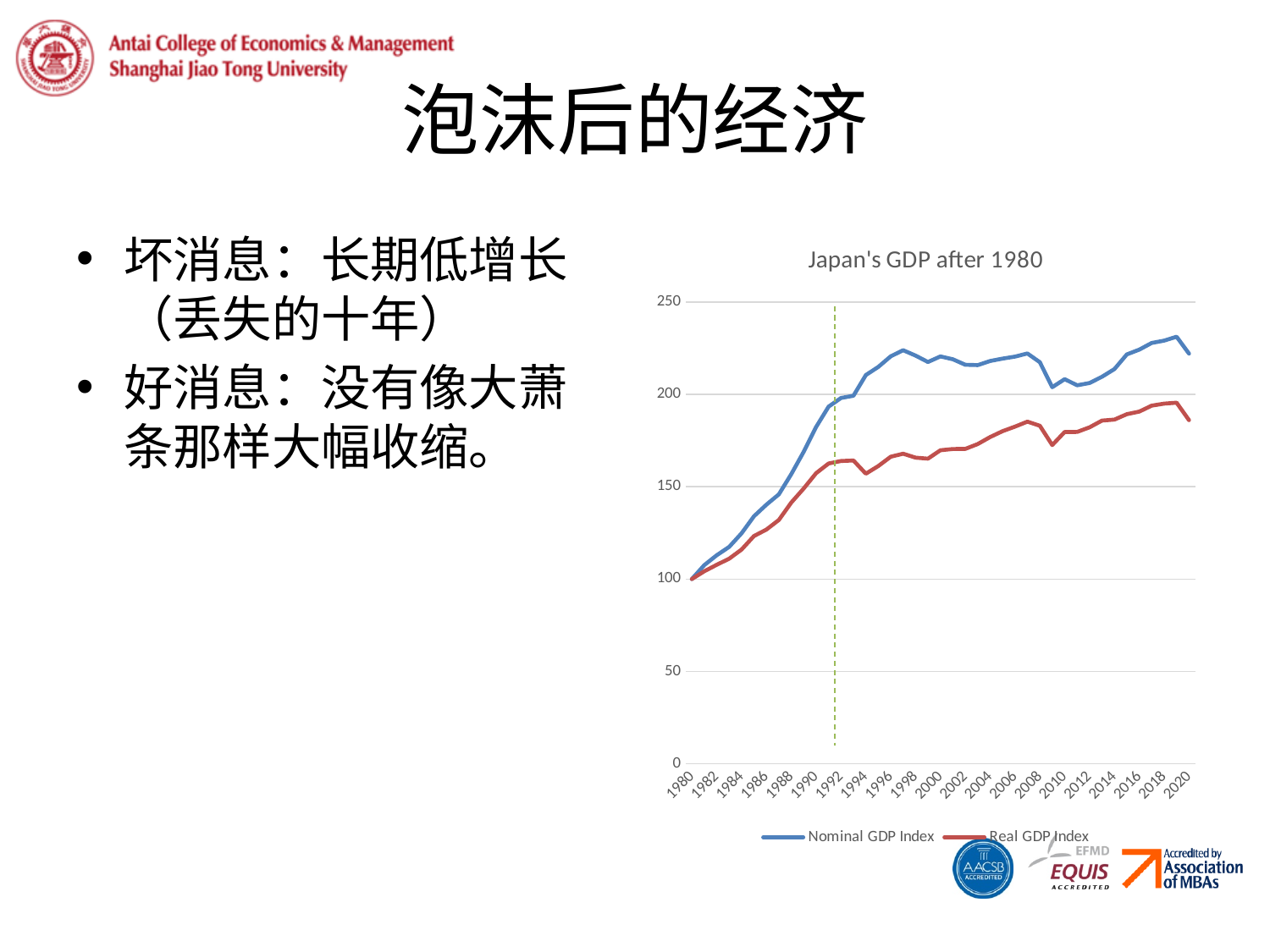
Is the value of the Nominal GDP Index in 2020 greater or less than 200? greater What is the title of the chart? Japan's GDP after 1980 In 2010, which series has the higher value, the Nominal GDP Index or the Real GDP Index? Nominal GDP Index Does the Nominal GDP Index rise or fall between 1980 and 1990? rise Which two series are listed in the chart's legend? Nominal GDP Index and Real GDP Index What is the value of the Nominal GDP Index in 1980? 100 What kind of chart is shown on the slide? line chart Is the value of the Real GDP Index in 1986 greater or less than 150? less How many series does the legend of the chart list? 2 What is the value of the Real GDP Index in 1980? 100 Is the value of the Nominal GDP Index in 1996 greater or less than 200? greater